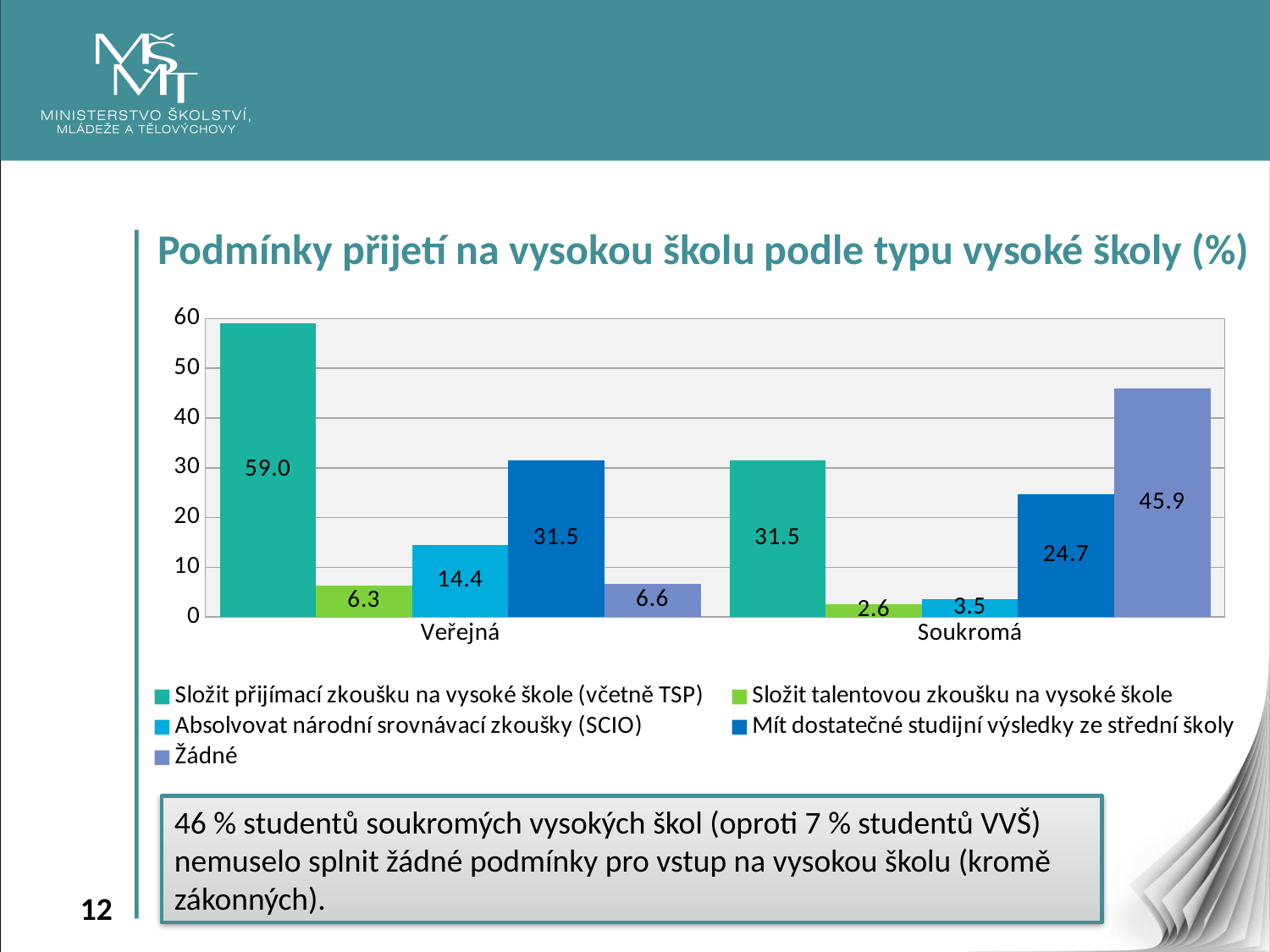
What is the value for 'Složit přijímací zkoušku na vysoké škole (včetně TSP)' in the Veřejná category? 59.0 How many categories are shown on the x axis? 2 What is the difference between the 'Žádné' values for Soukromá and Veřejná? 39.3 What is the title of the chart? Podmínky přijetí na vysokou školu podle typu vysoké školy (%) What is the value for 'Mít dostatečné studijní výsledky ze střední školy' in the Soukromá category? 24.7 What is the value for 'Absolvovat národní srovnávací zkoušky (SCIO)' in the Veřejná category? 14.4 Which is larger: the 'Složit přijímací zkoušku na vysoké škole (včetně TSP)' value for Veřejná or for Soukromá? Veřejná Which series has the lowest value in the Veřejná category? Složit talentovou zkoušku na vysoké škole How many series does the legend list? 5 What is the value for 'Žádné' in the Soukromá category? 45.9 What kind of chart is shown on the slide? Bar chart Which series has the highest value in the Soukromá category? Žádné